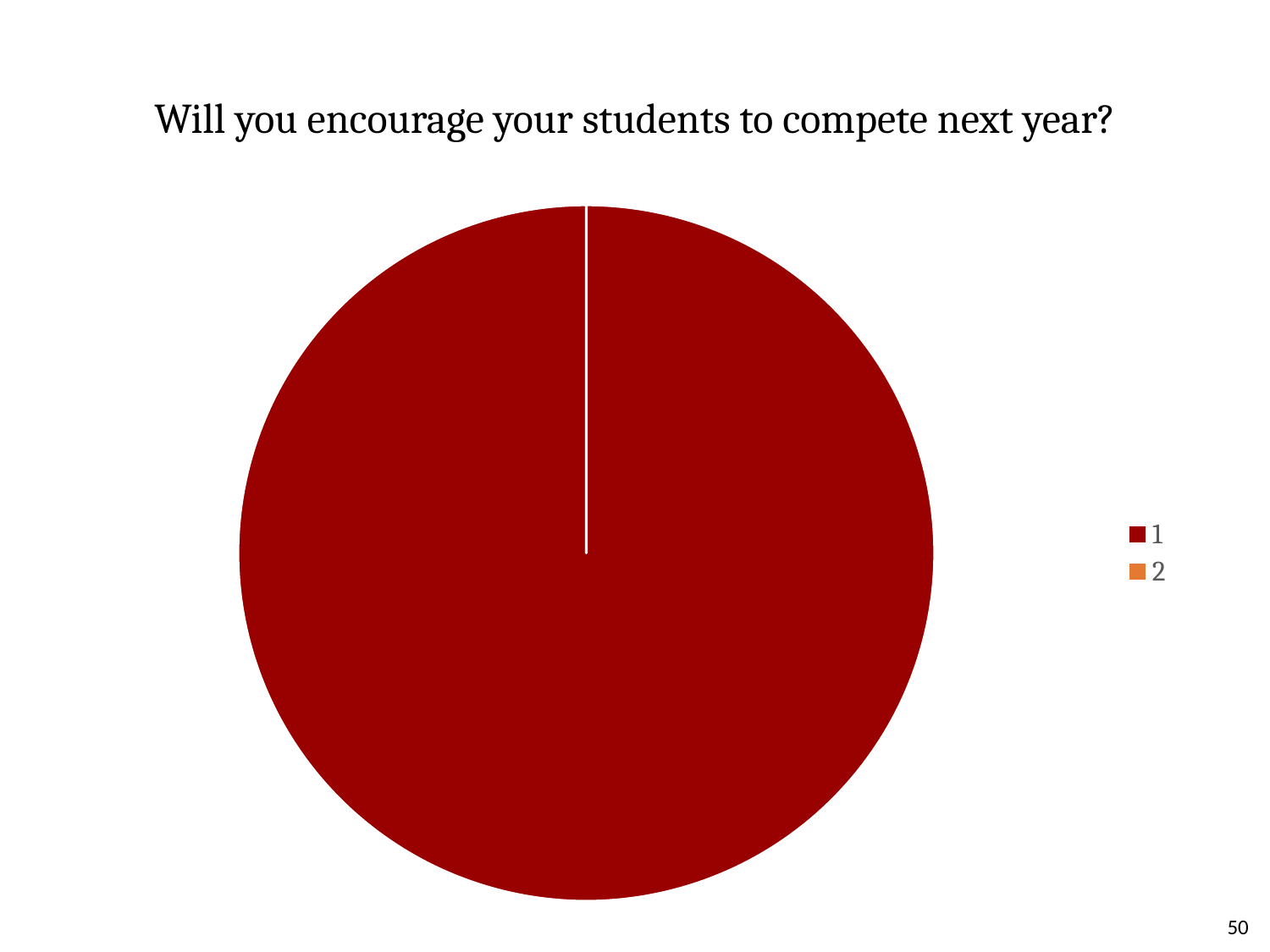
What colour represents category 1 in the legend? Dark red Is the share of the pie for category 1 greater or less than 50%? greater Which category takes up the smallest share of the pie? 2 What kind of chart is shown on the slide? Pie chart Which category takes up the largest share of the pie? 1 Which category has the larger share, 1 or 2? 1 What is the title of the chart? Will you encourage your students to compete next year? Is the share of the pie for category 2 greater or less than 50%? less How many categories does the legend list? 2